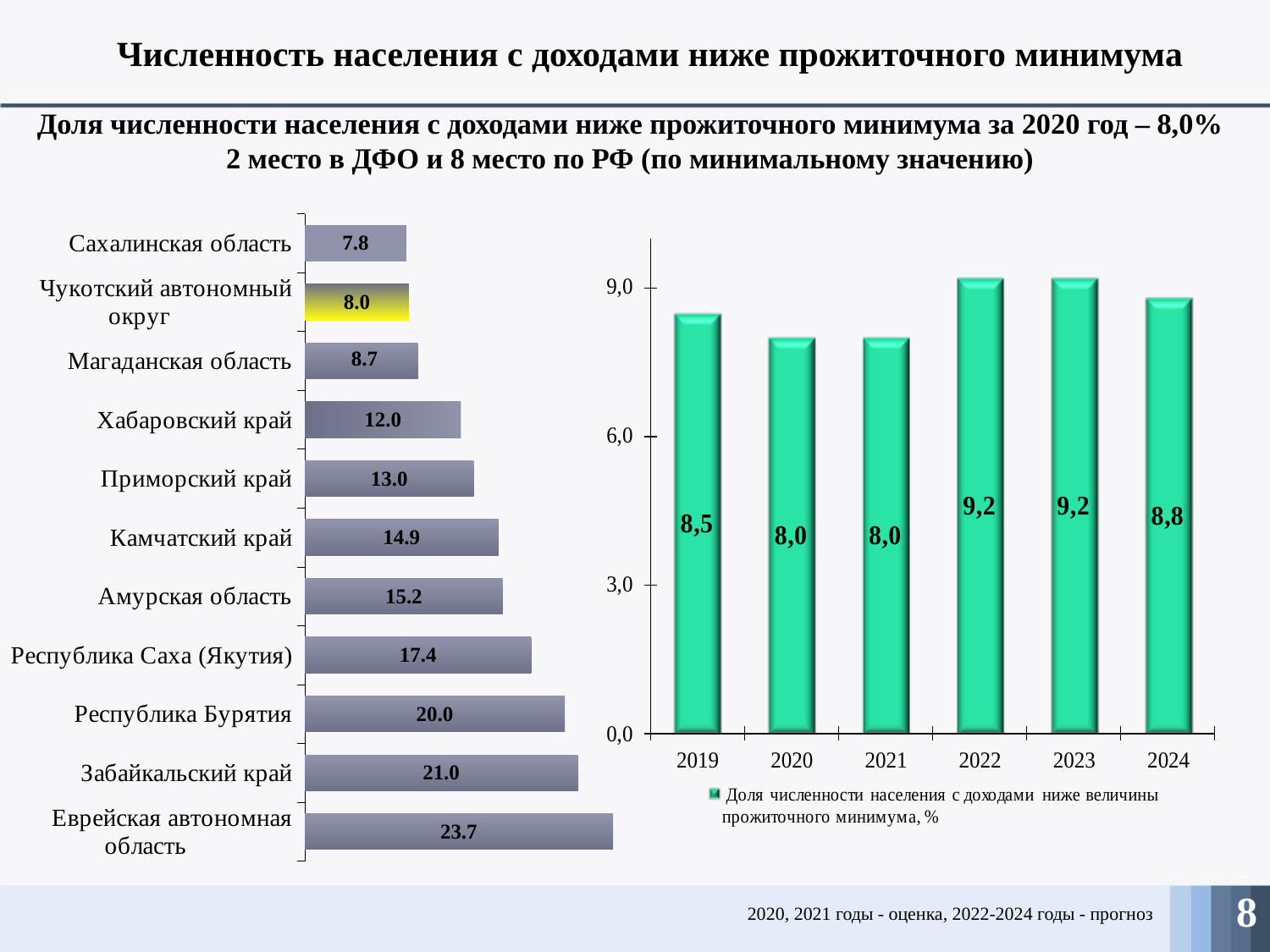
How many years are shown on the x axis of the right chart? 6 In the right chart, what is the value for 2019? 8,5 How many regions are shown in the left chart? 11 In the left chart, which region has the lowest value? Сахалинская область In the left chart, what is the difference between the values for Забайкальский край and Республика Бурятия? 1.0 In the left chart, which bar is highlighted in yellow? Чукотский автономный округ In the left chart, what is the value for Хабаровский край? 12.0 In the right chart, what is the difference between the values for 2024 and 2021? 0,8 In the right chart, what is the value for 2022? 9,2 What type of chart is the right chart? Bar chart In the left chart, which is larger: the value for Амурская область or Камчатский край? Амурская область In the left chart, which region has the highest value? Еврейская автономная область